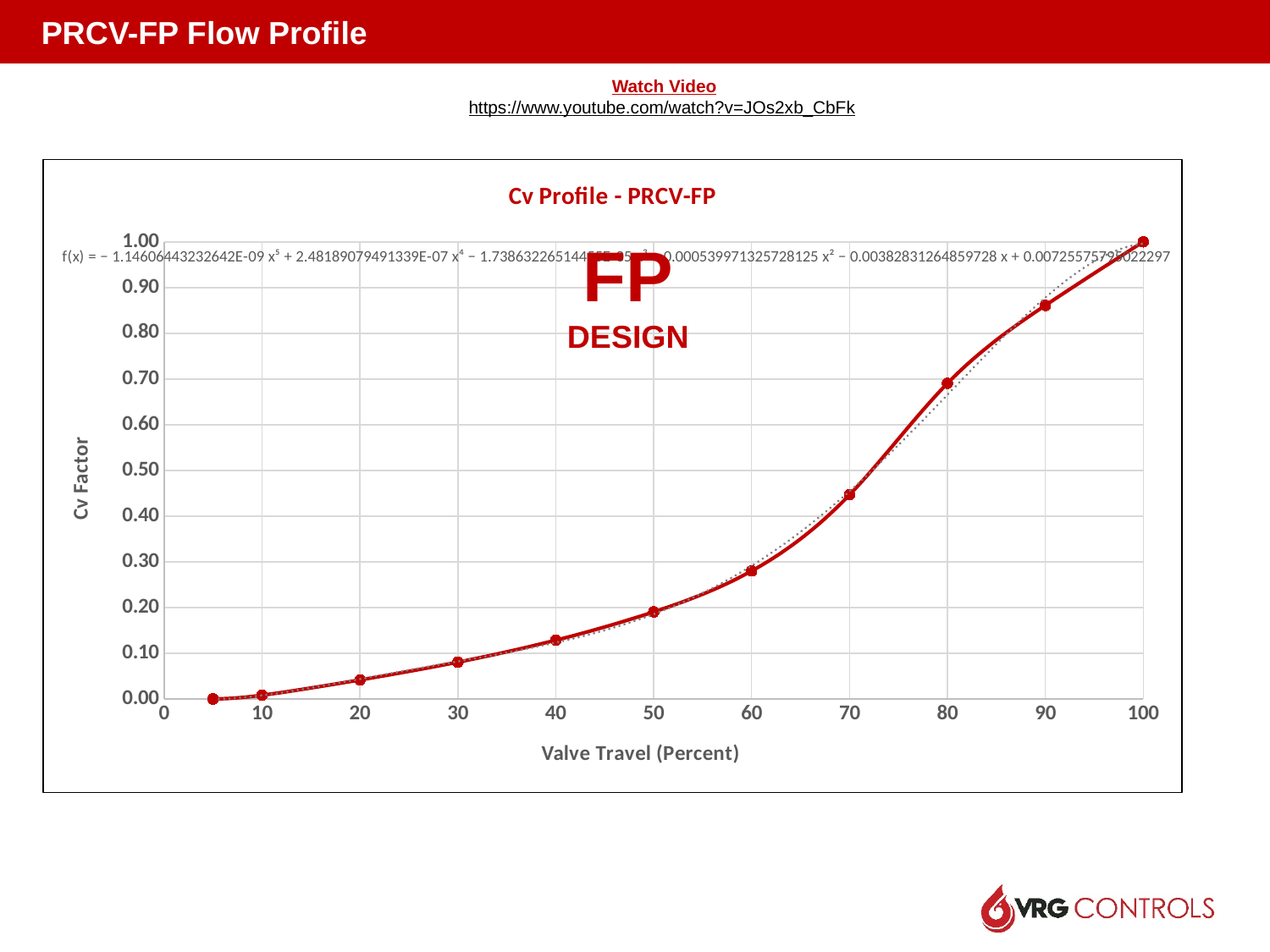
Is the Cv Factor at 20 percent valve travel greater or less than 0.10? less At which Valve Travel percentage is the Cv Factor highest? 100 What is the Cv Factor at 100 percent valve travel? 1.00 Is the Cv Factor at 70 percent valve travel greater or less than 0.50? less Is the Cv Factor at 90 percent valve travel greater or less than 0.80? greater Do the Cv Factor values rise or fall as Valve Travel increases from 0 to 100 percent? rise What kind of chart is shown on the slide? line chart What is the title of the chart? Cv Profile - PRCV-FP Which has the larger Cv Factor: 60 percent valve travel or 80 percent valve travel? 80 percent How many data points are plotted on the curve? 11 What is the label of the vertical axis? Cv Factor